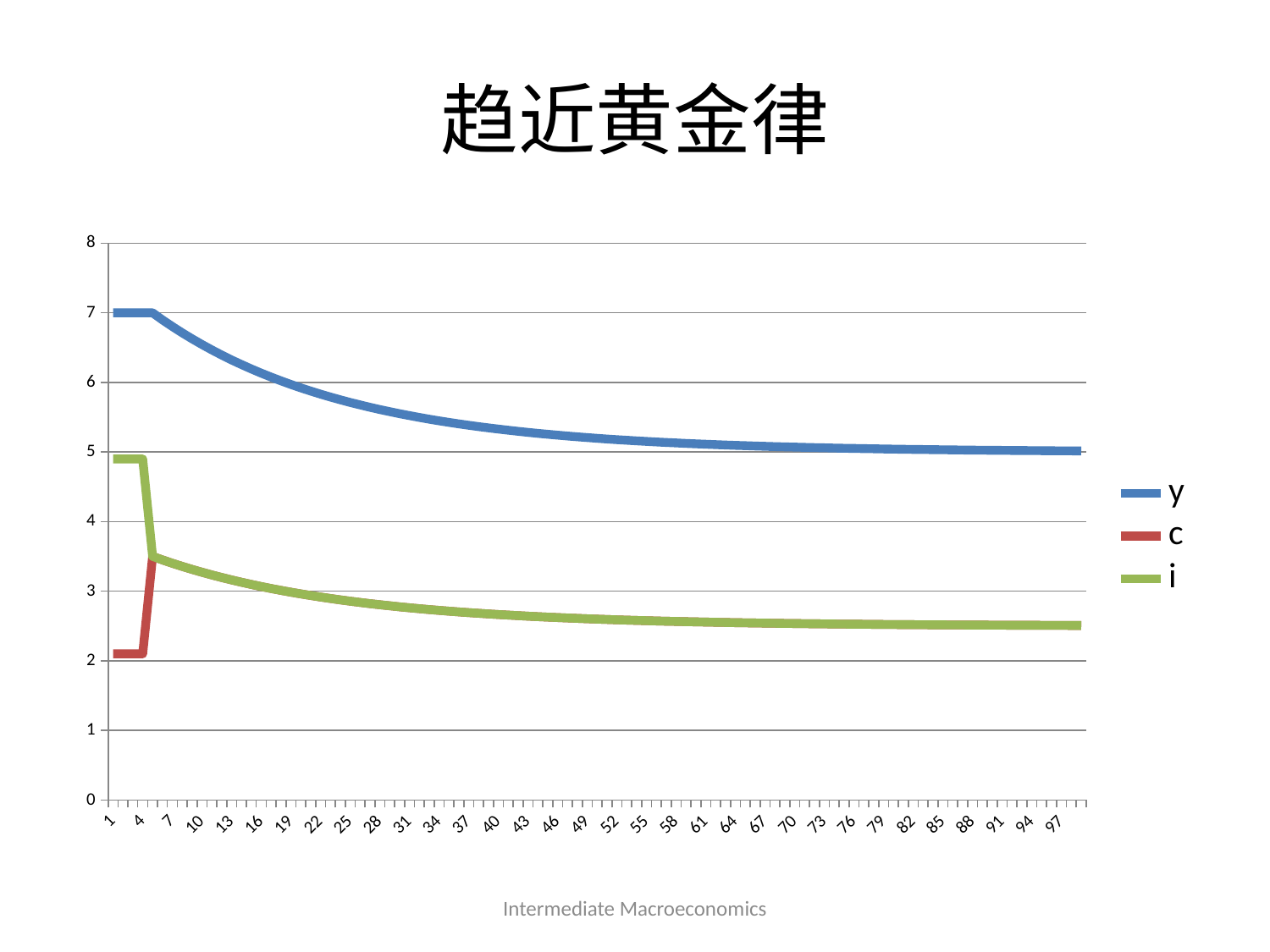
Is the value of y at period 97 greater or less than 6? less Which series has the highest value at period 97? y What is the value of y at period 1? 7 How many series does the legend list? 3 Is the value of i at period 1 greater or less than 4? greater At period 1, which is larger, i or c? i Is the value of c at period 1 greater or less than 3? less What are the series names listed in the legend? y, c, i What is the title of the slide containing the chart? 趋近黄金律 Does the y series rise or fall along the x axis after period 4? fall What kind of chart is shown on the slide? line chart